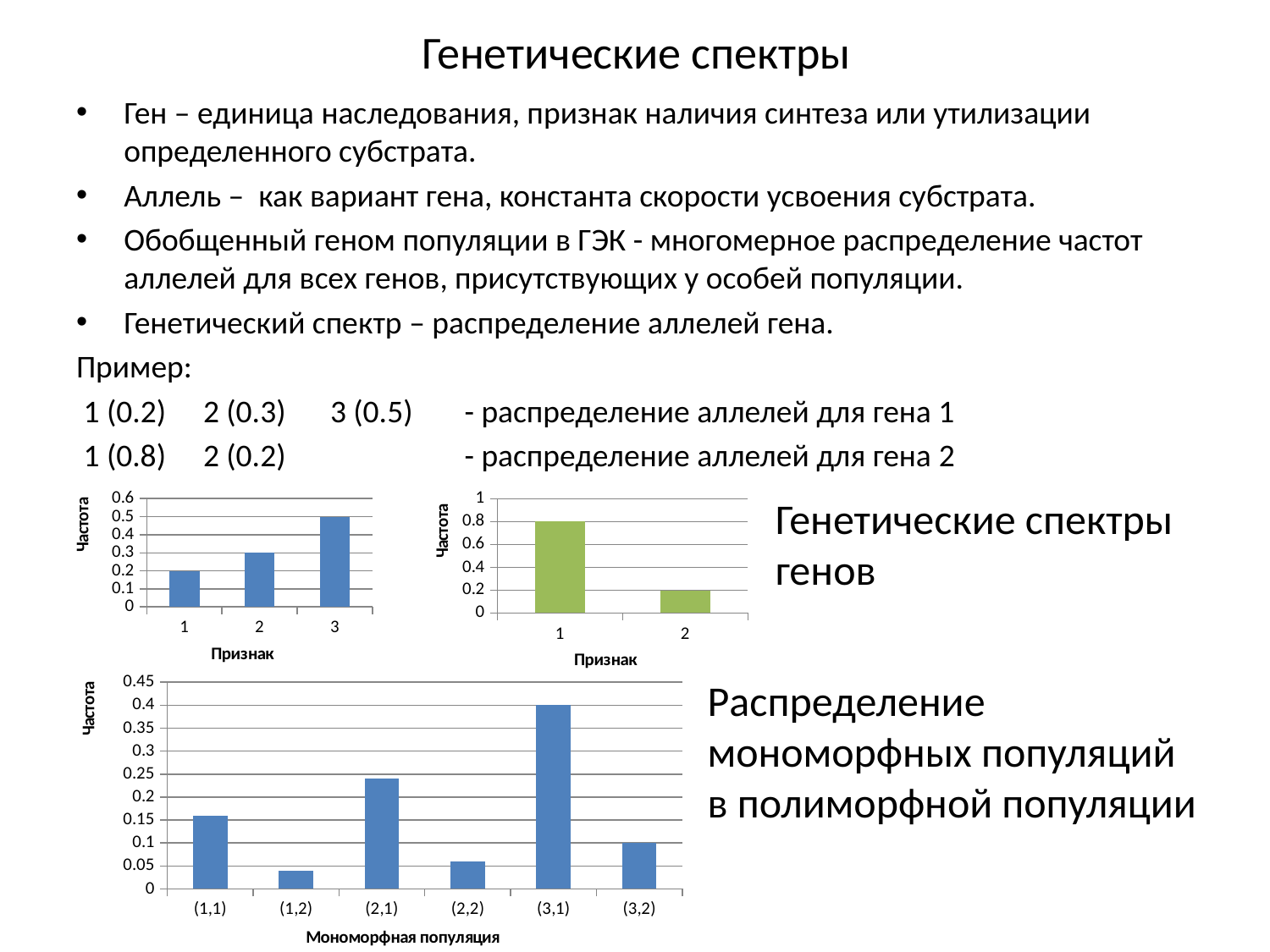
On the top-right chart, what is the value for category 1? 0.8 On the top-right chart, what is the difference between the values for category 1 and category 2? 0.6 On the top-left chart, what is the value for category 3? 0.5 On the top-left chart, what is the difference between the values for category 3 and category 1? 0.3 On the top-left chart, which category has the lowest value? 1 On the bottom chart, is the value for (2,1) greater or less than 0.2? greater On the bottom chart, how many categories are shown on the x axis? 6 On the bottom chart, which category has the highest value? (3,1) What kind of chart is the bottom chart? Bar chart On the top-right chart, how many categories are shown on the x axis? 2 On the bottom chart, what is the value for (3,1)? 0.4 On the bottom chart, which is larger, the value for (1,1) or the value for (1,2)? (1,1)